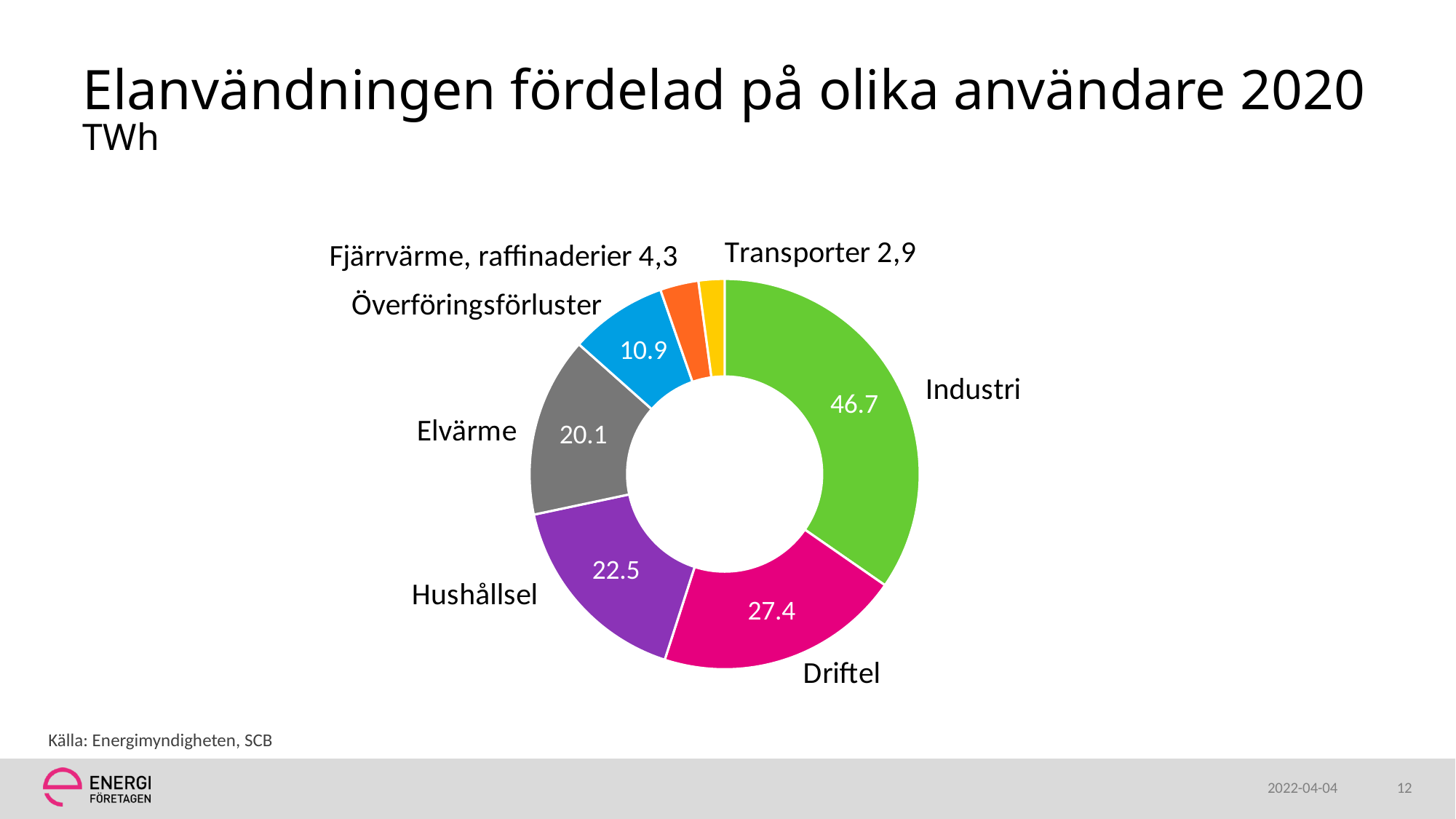
Which is larger, Hushållsel or Elvärme? Hushållsel What is the value for Transporter? 2,9 What kind of chart is shown on the slide? Doughnut chart What is the value for Hushållsel? 22.5 Which category has the smallest share of the chart? Transporter What is the value for Driftel? 27.4 What is the value for Industri? 46.7 How many categories are shown in the chart? 7 Which category has the largest share of the chart? Industri What is the difference between the values for Industri and Driftel? 19.3 What unit is stated under the chart title? TWh What is the value for Överföringsförluster? 10.9